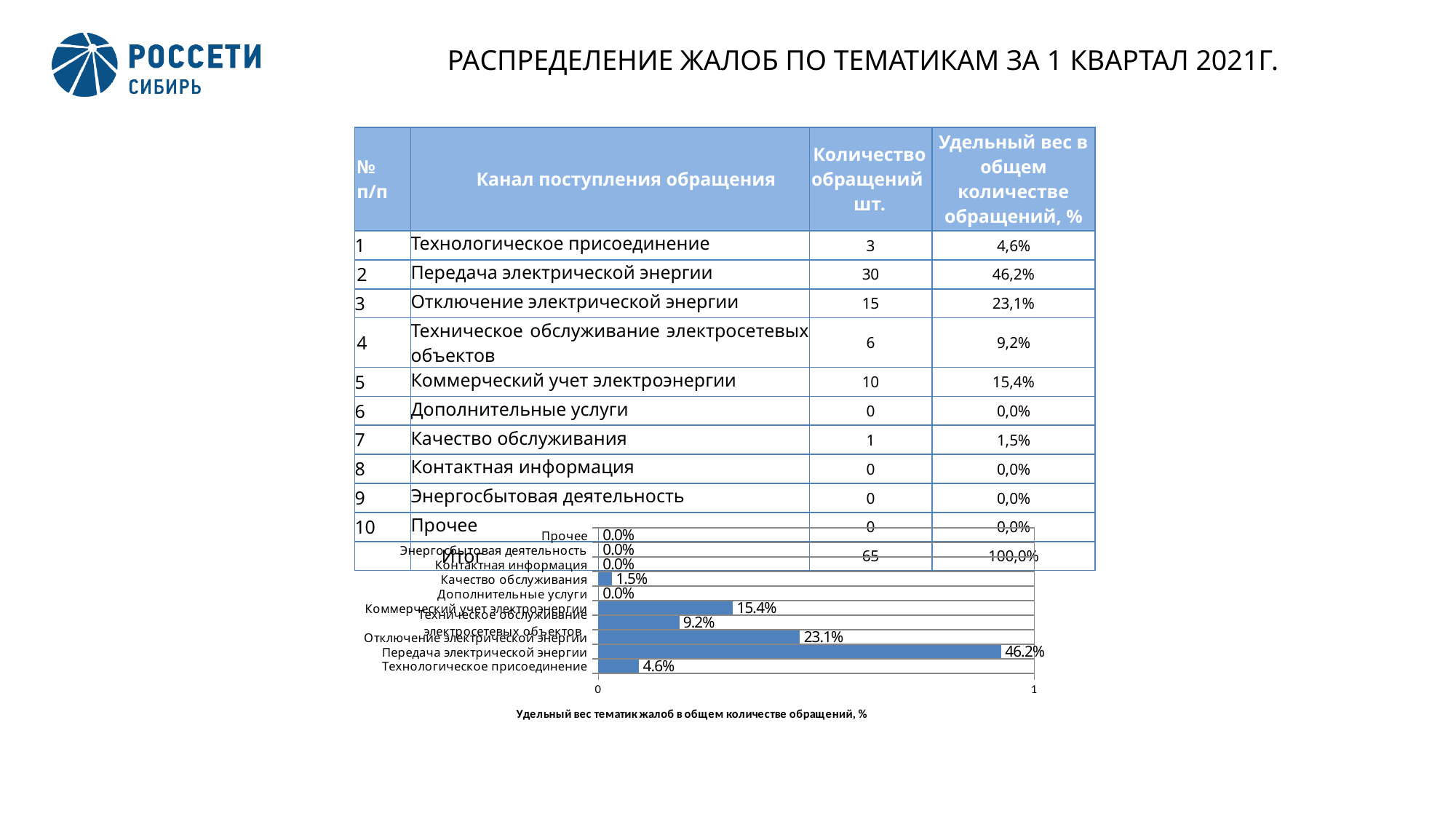
What is the value for Технологическое присоединение in the chart? 4.6% How many categories are shown in the chart? 10 Which is larger in the chart: Коммерческий учет электроэнергии or Техническое обслуживание электросетевых объектов? Коммерческий учет электроэнергии How many categories in the chart have a value of 0.0%? 4 What is the value for Отключение электрической энергии in the chart? 23.1% What is the value for Качество обслуживания in the chart? 1.5% What is the difference between the values for Передача электрической энергии and Отключение электрической энергии? 23.1% What is the value for Коммерческий учет электроэнергии in the chart? 15.4% Which category has the highest value in the chart? Передача электрической энергии What is the value for Передача электрической энергии in the chart? 46.2% What type of chart is shown on the slide? bar chart